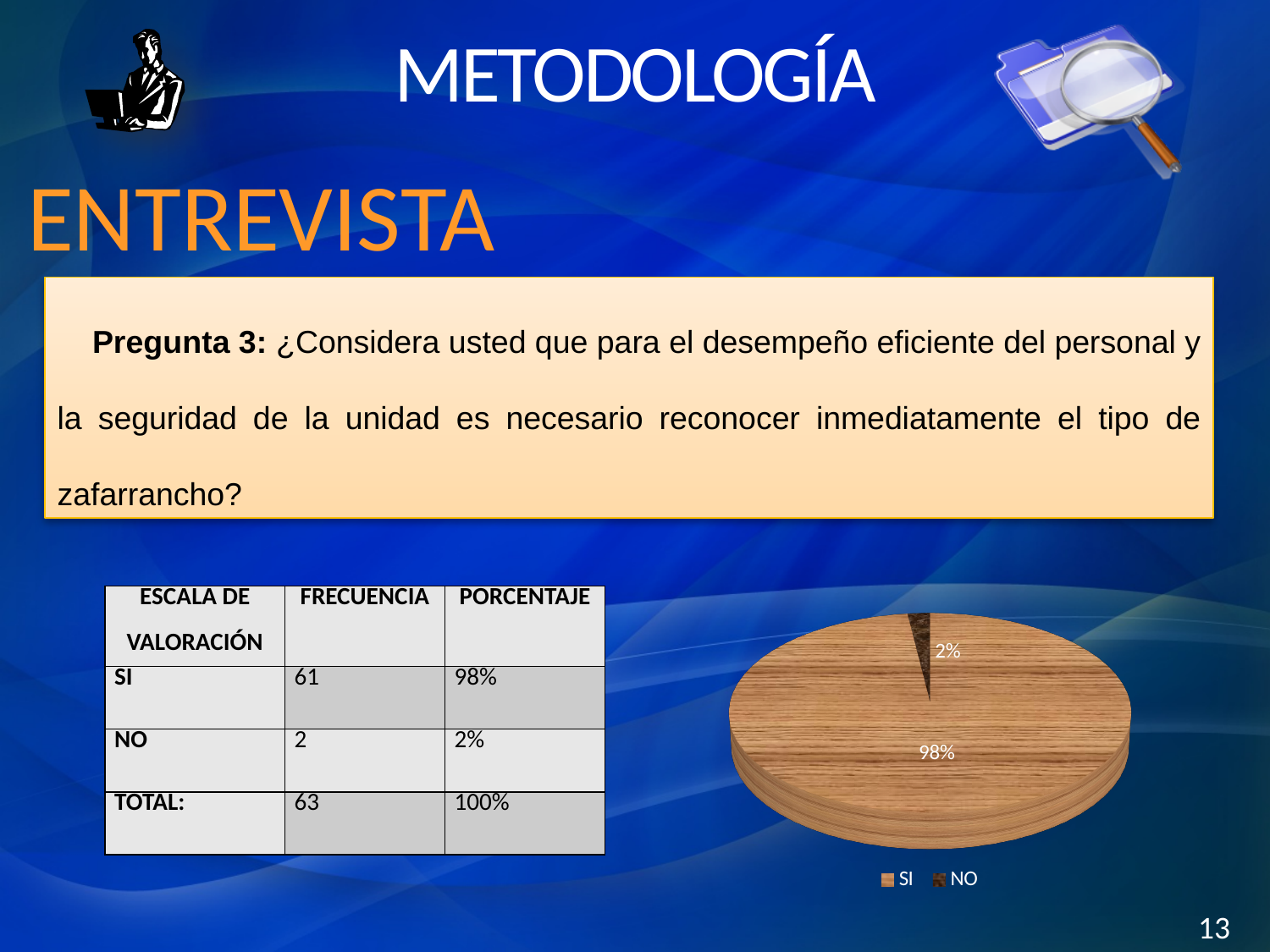
Which category has the largest slice in the pie chart? SI What are the two legend entries of the pie chart? SI and NO What kind of chart is shown on the slide? pie chart What share of the pie does the SI slice represent? 98% What percentage does the NO slice of the pie chart show? 2% What percentage does the SI slice of the pie chart show? 98% How many entries does the legend of the pie chart list? 2 How many slices does the pie chart have? 2 Which category has the smallest slice in the pie chart? NO Which slice is larger, SI or NO? SI What is the difference in percentage points between the SI and NO slices? 96